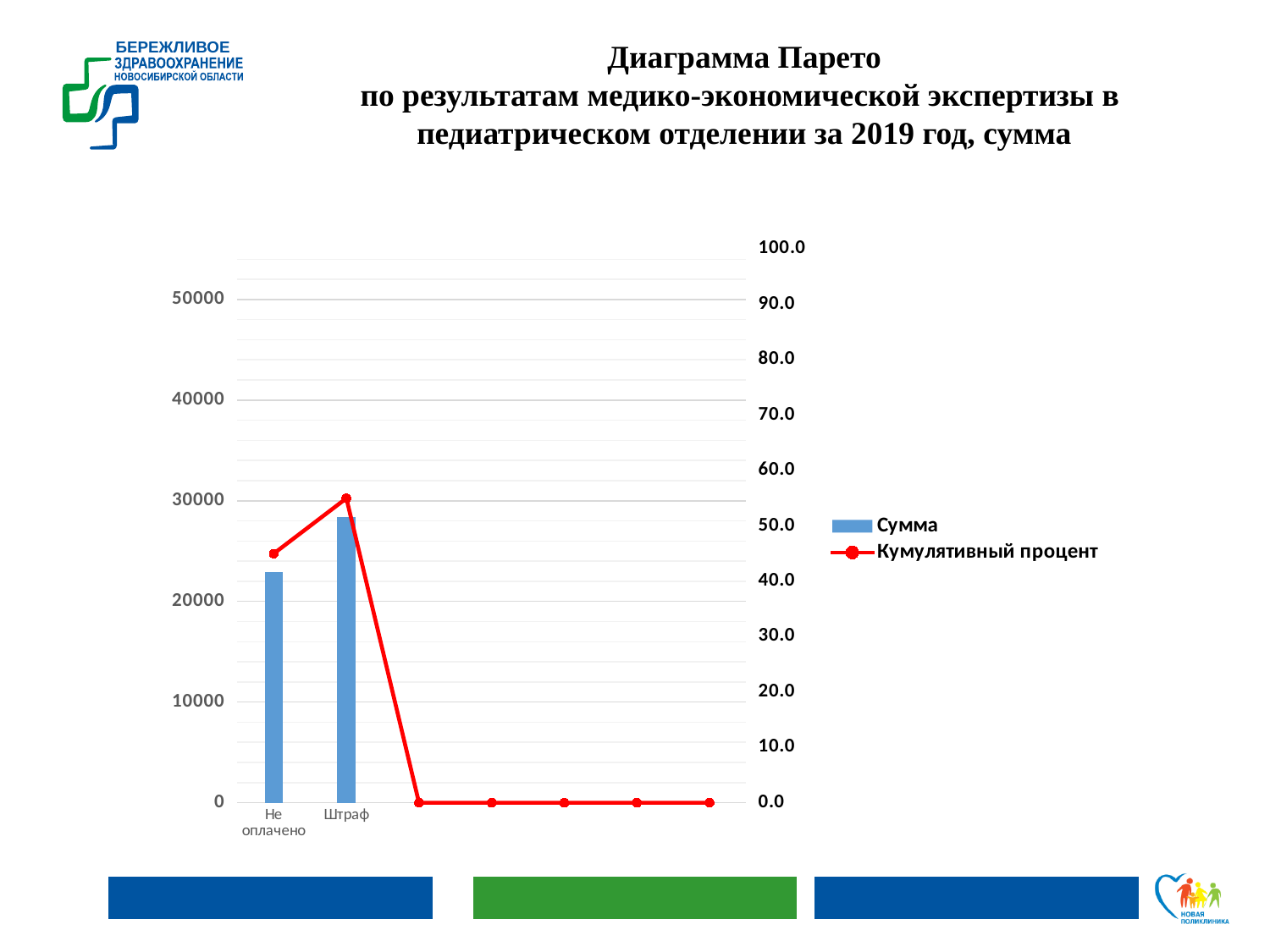
Is the Кумулятивный процент value for Штраф greater or less than 60.0? less How many series does the legend list? 2 Is the Сумма value for Штраф greater or less than 30000? less Which of the labelled categories has the highest Сумма value? Штраф Which series is drawn as bars? Сумма Which series is drawn as a red line with markers? Кумулятивный процент Which bar is taller, Не оплачено or Штраф? Штраф What is the highest tick value shown on the right-hand axis? 100.0 Which of the labelled categories has the lowest Сумма value? Не оплачено What kind of chart is shown on the slide? A combined bar and line chart (Pareto chart) Is the Сумма value for Не оплачено greater or less than 20000? greater